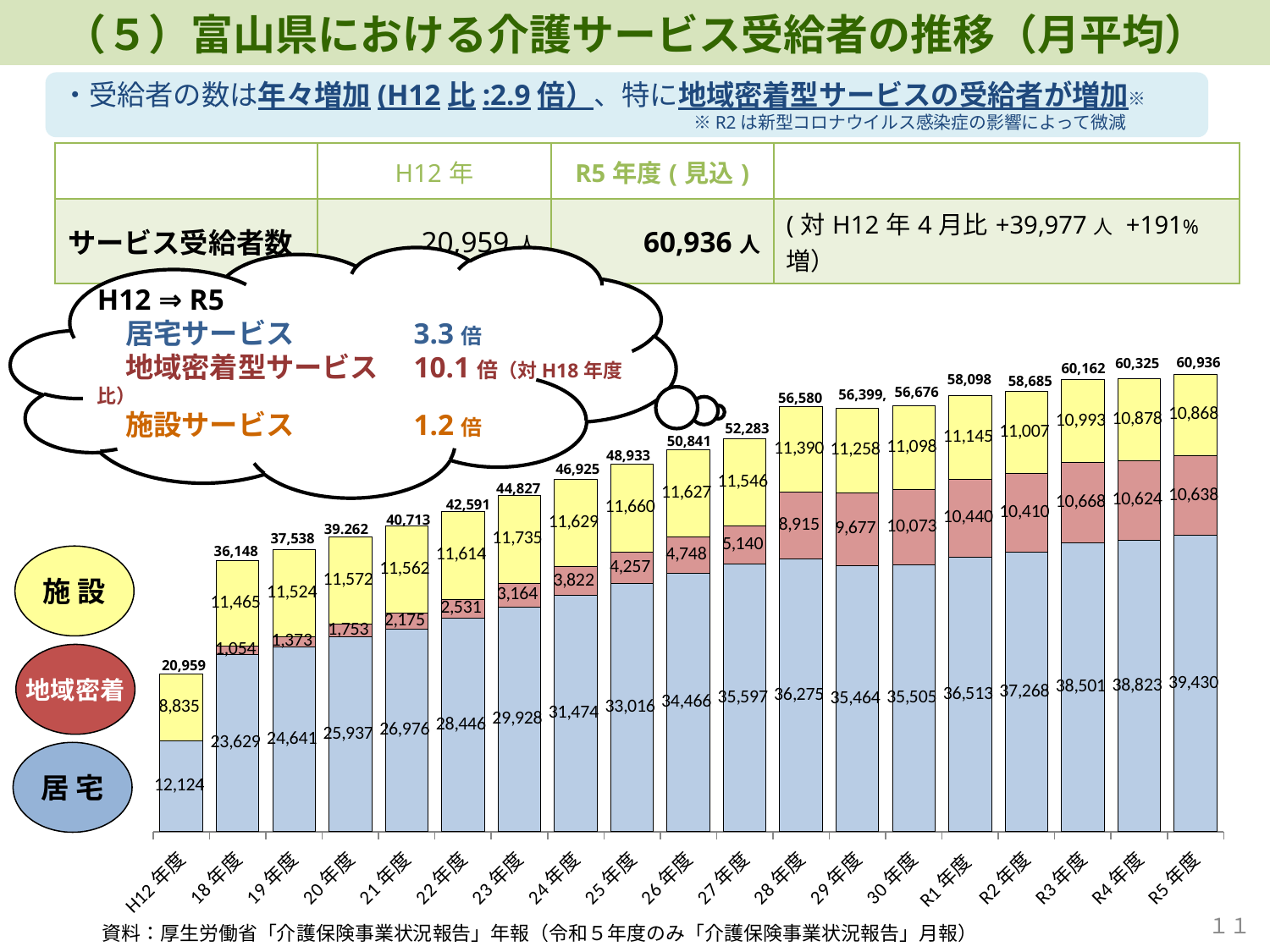
How many fiscal years are shown on the x axis? 19 What is the value for 居宅 in R5年度? 39,430 What is the value for 施設 in H12年度? 8,835 Do the total values generally rise or fall from H12年度 to R5年度? Rise Which fiscal year has the highest total number of recipients? R5年度 What is the total of the stacked bar for R3年度? 60,162 What is the value for 地域密着 in 28年度? 8,915 How many series does the chart show? 3 In R5年度, which is larger, the value for 施設 or the value for 地域密着? 施設 Which fiscal year has the lowest total number of recipients? H12年度 What kind of chart is shown on the slide? Stacked bar chart What is the difference between the total for R5年度 and the total for H12年度? 39,977